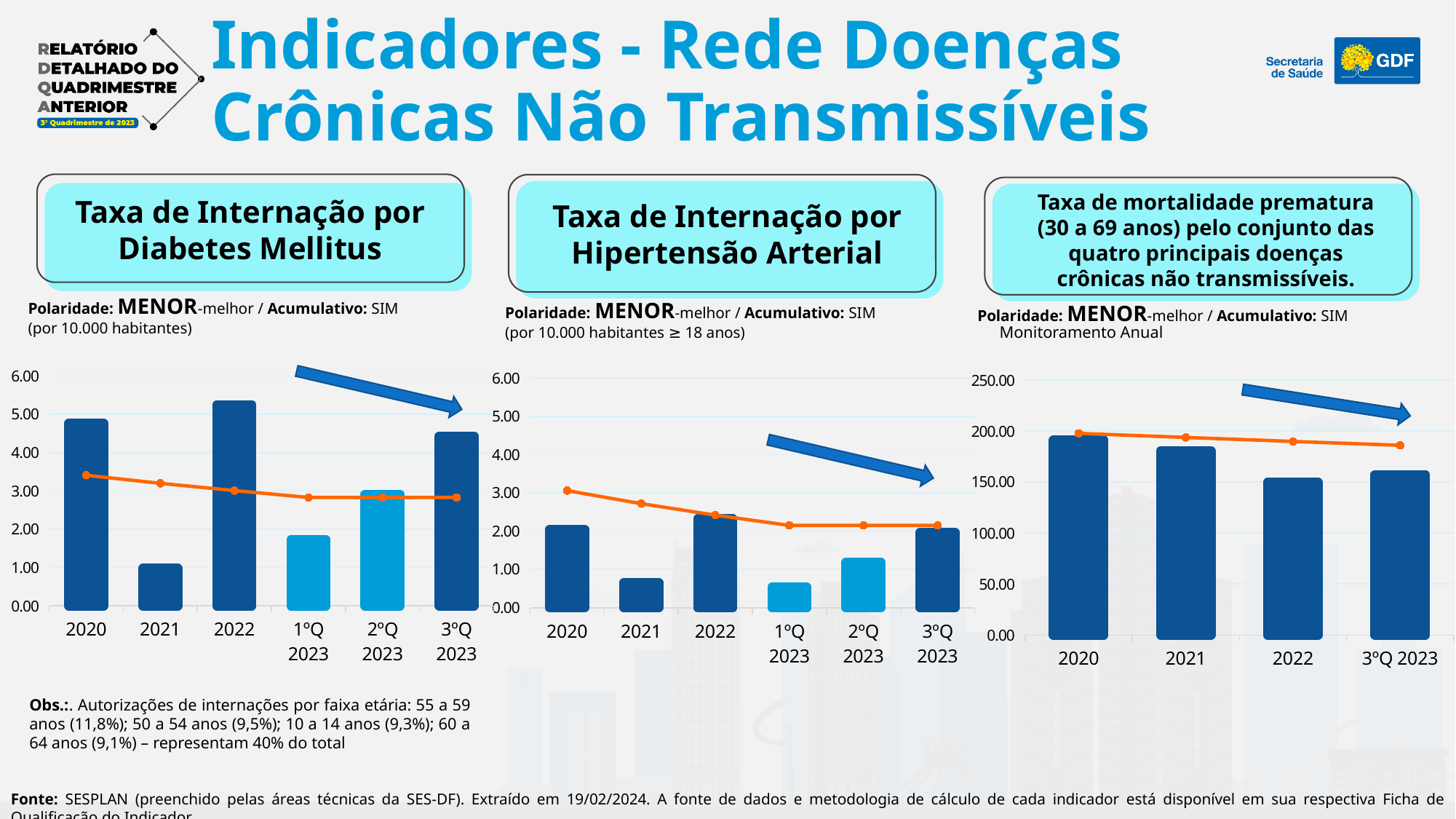
In the Taxa de mortalidade prematura chart, is the bar for 2021 greater or less than 150.00? greater In the Taxa de Internação por Hipertensão Arterial chart, which bar is taller: 2020 or 2021? 2020 How many categories are shown on the x axis of the Taxa de Internação por Diabetes Mellitus chart? 6 In the Taxa de Internação por Hipertensão Arterial chart, is the bar for 2021 greater or less than 1.00? less In the Taxa de mortalidade prematura chart, which category has the tallest bar? 2020 In the Taxa de Internação por Hipertensão Arterial chart, which category has the tallest bar? 2022 In the Taxa de Internação por Diabetes Mellitus chart, which category has the tallest bar? 2022 In the Taxa de mortalidade prematura chart, does the orange line rise or fall from 2020 to 3ºQ 2023? fall In the Taxa de Internação por Diabetes Mellitus chart, which category has the shortest bar? 2021 In the Taxa de Internação por Diabetes Mellitus chart, which bar is taller: 2ºQ 2023 or 3ºQ 2023? 3ºQ 2023 How many categories are shown on the x axis of the Taxa de mortalidade prematura chart? 4 In the Taxa de Internação por Diabetes Mellitus chart, is the bar for 2020 greater or less than 4.00? greater